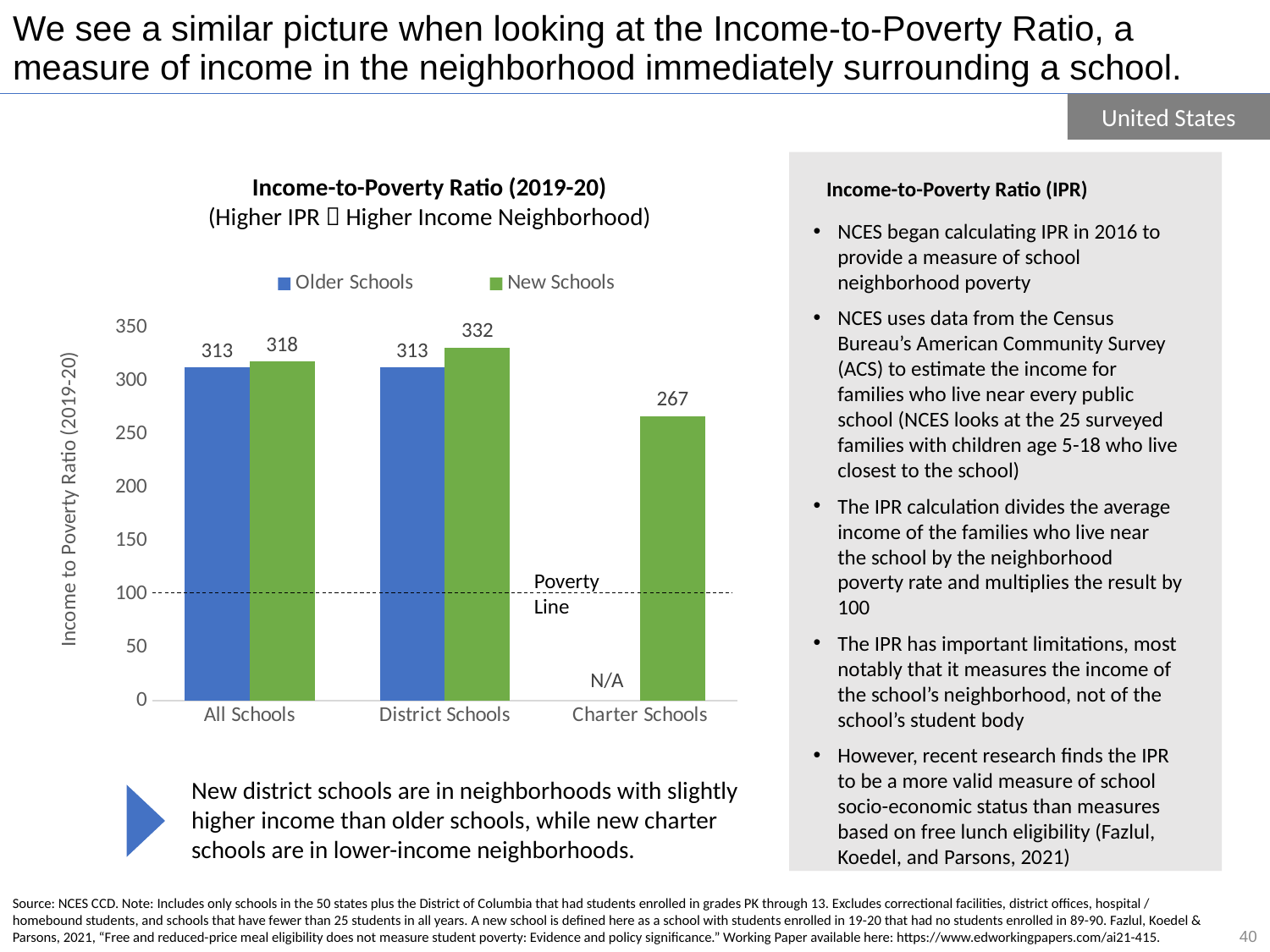
Which is larger in the All Schools category: Older Schools or New Schools? New Schools How many series does the legend list? 2 What is the Income-to-Poverty Ratio for New Schools in the District Schools category? 332 What is the difference between New Schools and Older Schools in the District Schools category? 19 Which category has the lowest value for New Schools? Charter Schools What is the Income-to-Poverty Ratio for Older Schools in the All Schools category? 313 Is the value for New Schools in the Charter Schools category greater or less than 250? greater What kind of chart is shown on the slide? Bar chart What is the difference between New Schools and Older Schools in the All Schools category? 5 What value is shown for Older Schools in the Charter Schools category? N/A What is the Income-to-Poverty Ratio for New Schools in the Charter Schools category? 267 Which category has the highest value for New Schools? District Schools